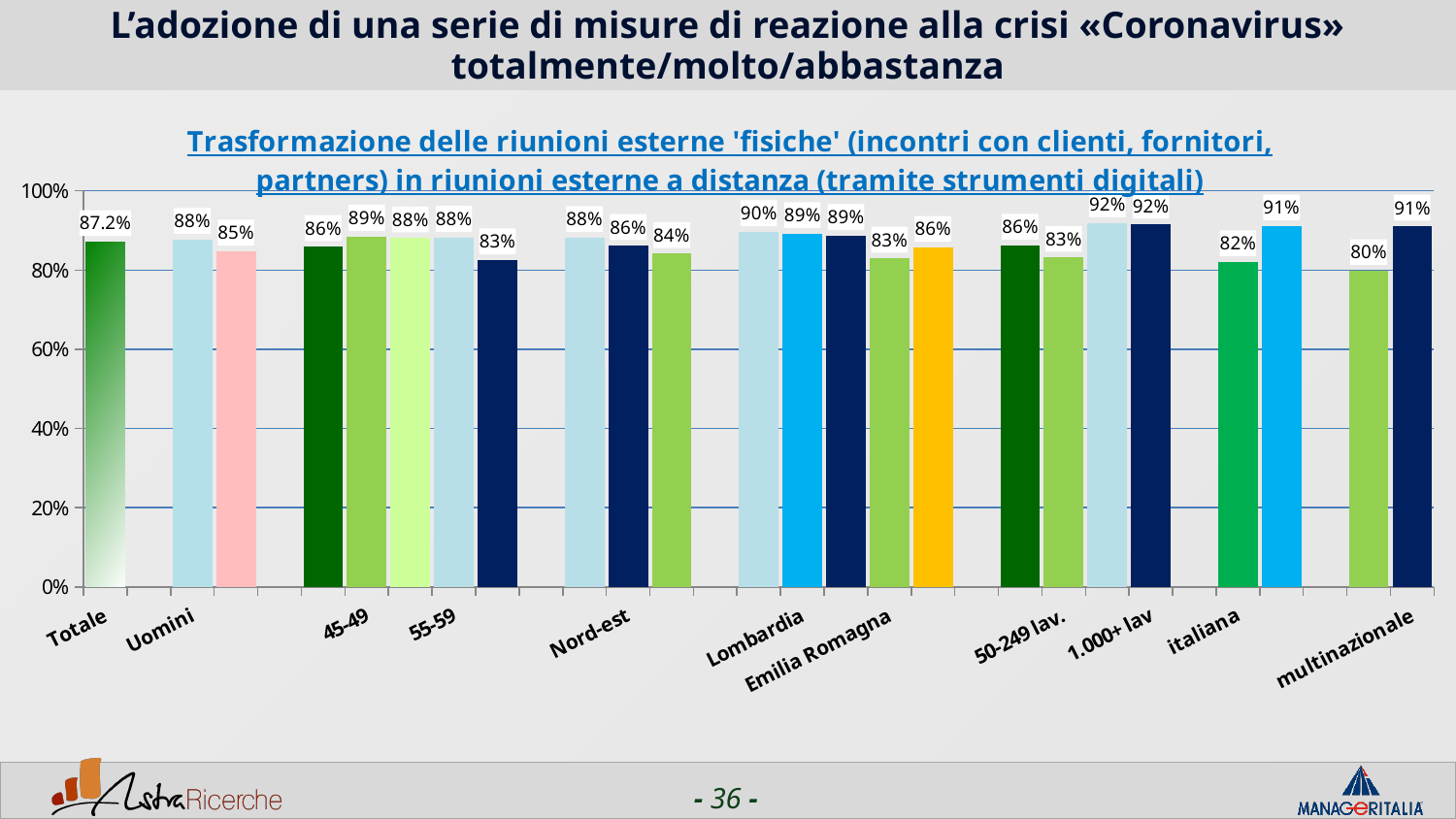
What is the value for 1.000+ lav? 92% What is the value for italiana? 82% What is the value for Totale? 87.2% How many bars are plotted in the chart? 24 What is the difference between the value for 1.000+ lav and the value for 50-249 lav.? 9% Which is larger, the value for italiana or the value for multinazionale? multinazionale What is the value for 45-49? 89% What is the value for Uomini? 88% What kind of chart is shown on the slide? bar chart What is the value for multinazionale? 91% Which is larger, the value for Lombardia or the value for Emilia Romagna? Lombardia What is the value for Nord-est? 86%